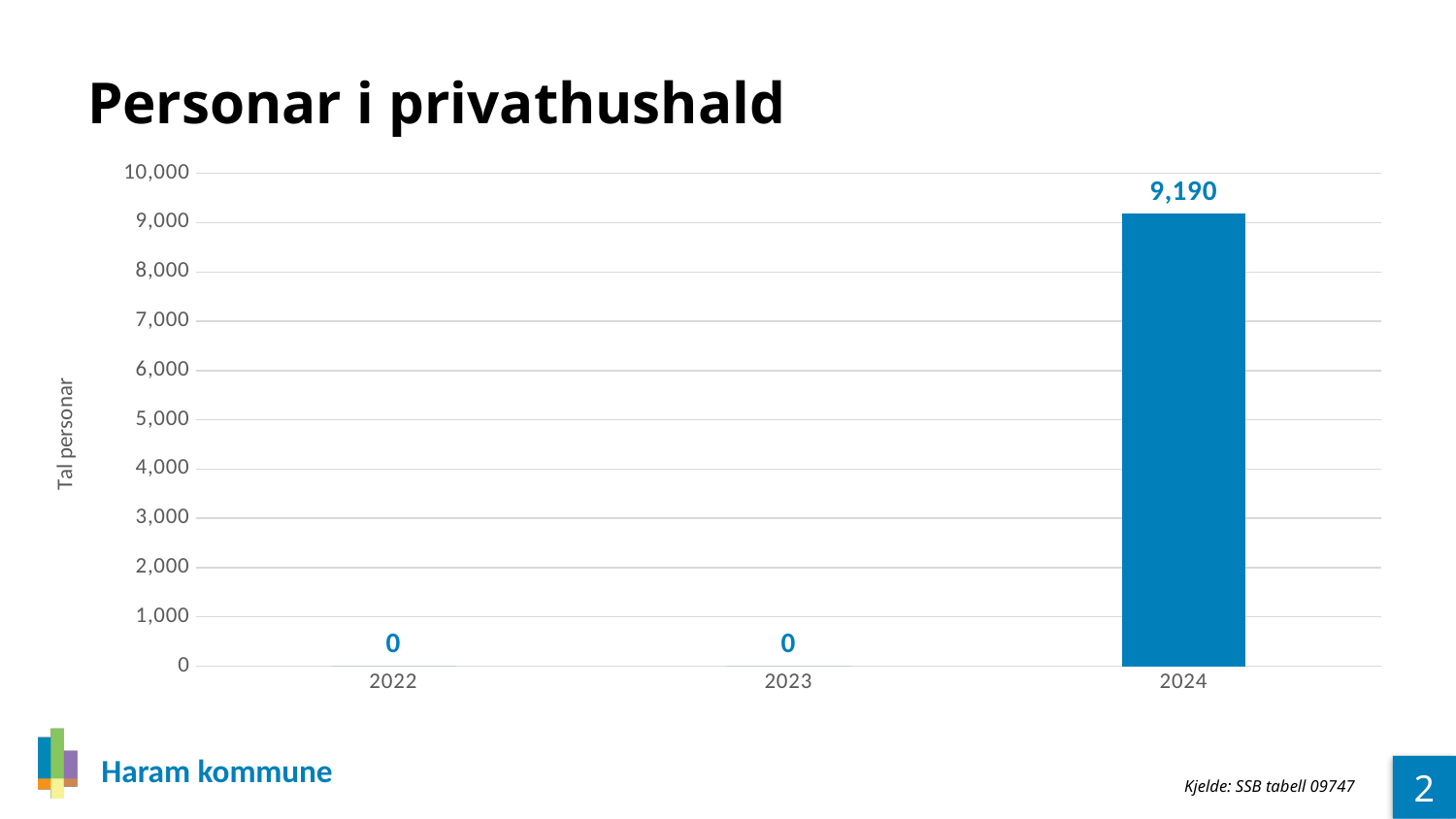
Which is larger, the value for 2024 or the value for 2022? 2024 What is the value for 2022? 0 Which year has the highest value? 2024 Is the value for 2024 greater or less than 9,000? greater How many years are shown on the x axis? 3 What kind of chart is shown on the slide? bar chart What is the label of the y axis? Tal personar Do the values rise or fall from 2022 to 2024? rise What is the value for 2024? 9,190 What is the title of the chart? Personar i privathushald What is the value for 2023? 0 What is the difference between the values for 2024 and 2023? 9,190